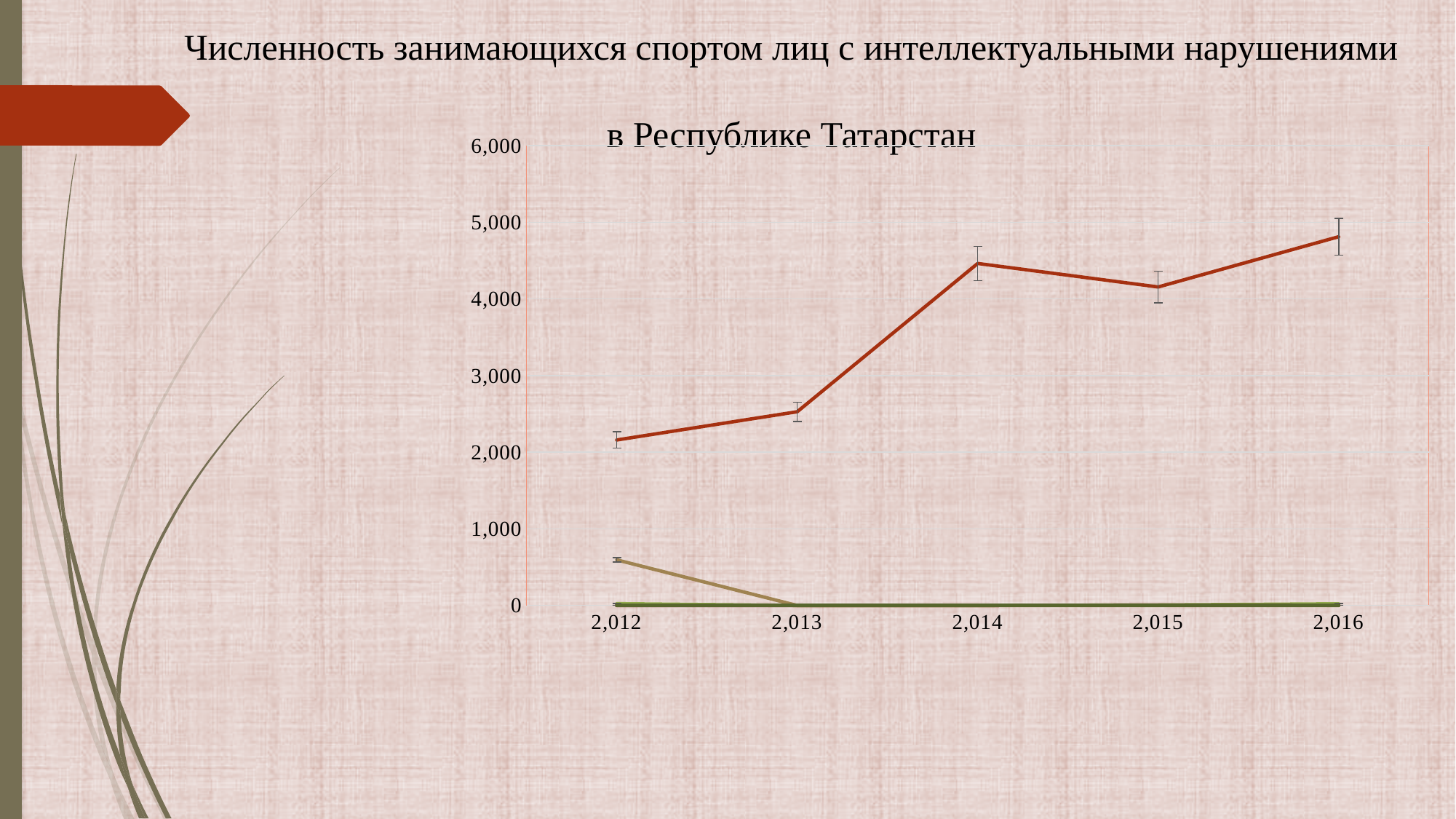
Which year has the larger value on the red line, 2,014 or 2,015? 2,014 Is the value of the red line for 2,016 greater or less than 5,000? less In which year does the red line reach its highest value? 2,016 What kind of chart is shown on the slide? Line chart What is the last year shown on the x axis of the chart? 2,016 Is the value of the red line for 2,014 greater or less than 4,000? greater In which year does the red line have its lowest value? 2,012 What is the maximum value shown on the y axis of the chart? 6,000 How many years are shown along the x axis of the chart? 5 What is the first year shown on the x axis of the chart? 2,012 Does the red line rise or fall from 2,012 to 2,014? Rise Is the value of the red line for 2,013 greater or less than 3,000? less